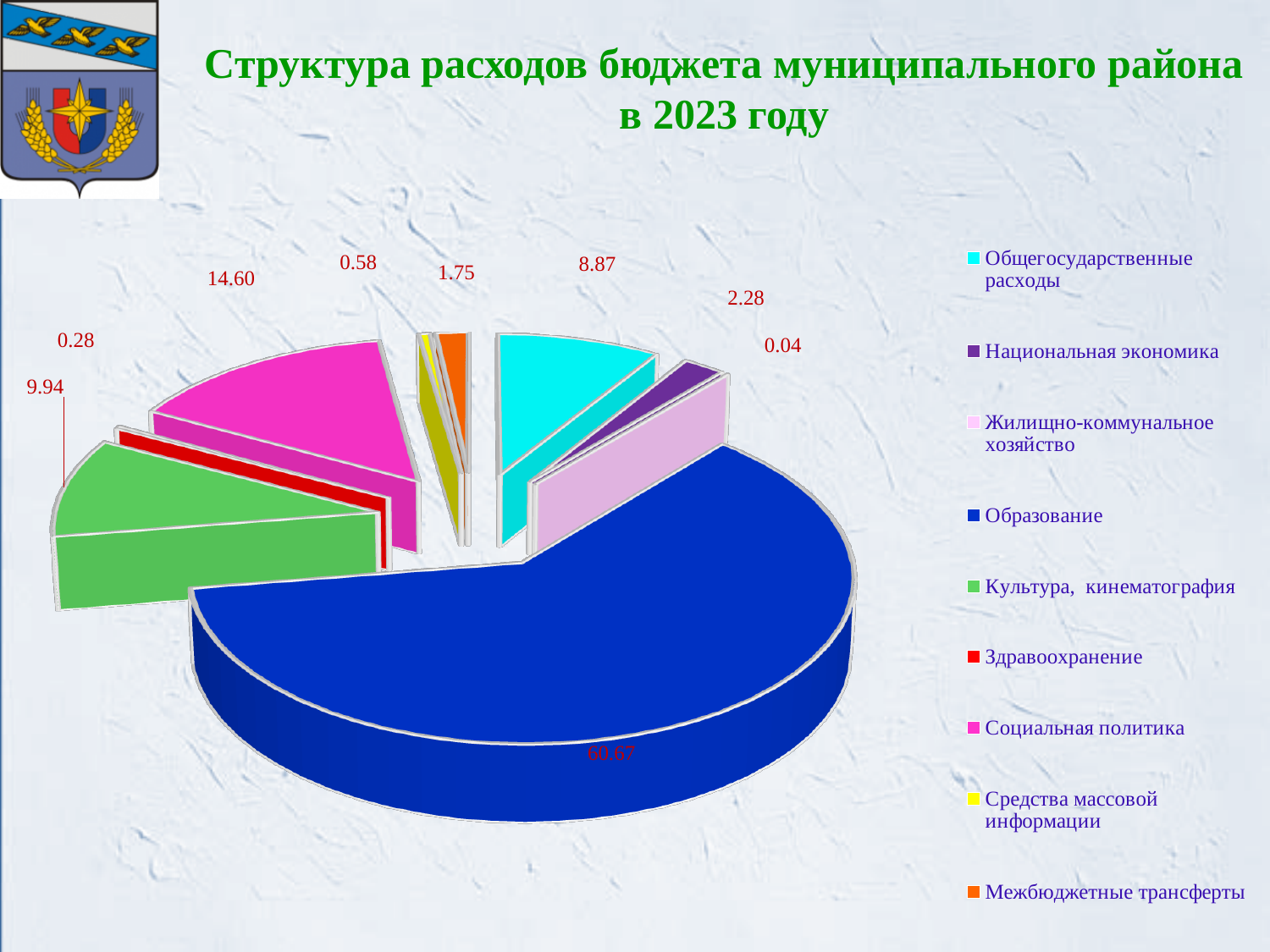
What is the value shown for Общегосударственные расходы? 8.87 What is the title of the chart on the slide? Структура расходов бюджета муниципального района в 2023 году What is the value shown for Образование? 60.67 What is the value shown for Социальная политика? 14.60 What is the value shown for Культура, кинематография? 9.94 What is the difference between the values for Социальная политика and Культура, кинематография? 4.66 What is the value shown for Здравоохранение? 0.28 What type of chart is shown on the slide? pie chart How many categories does the legend of the pie chart list? 9 What is the value shown for Межбюджетные трансферты? 1.75 Which is larger, the value for Социальная политика or the value for Культура, кинематография? Социальная политика Which category has the largest share of the pie? Образование